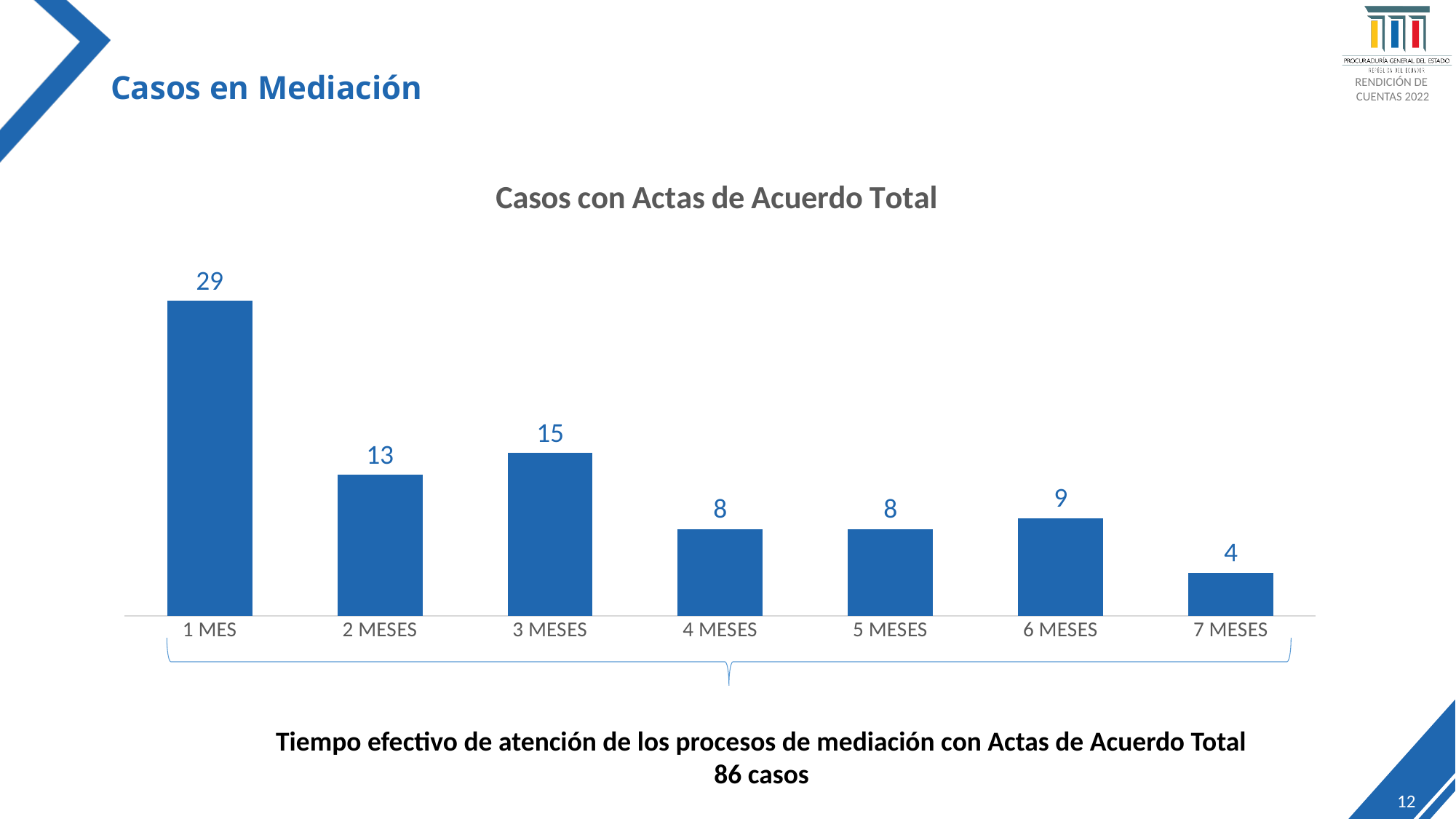
What is the title of the chart? Casos con Actas de Acuerdo Total Which category has the lowest value? 7 MESES What is the value for 1 MES? 29 What kind of chart is shown on the slide? Bar chart Which category has the highest value? 1 MES Which is larger, the value for 2 MESES or the value for 3 MESES? 3 MESES What is the value for 7 MESES? 4 What is the difference between the values for 1 MES and 2 MESES? 16 How many categories are shown on the x axis? 7 What is the value for 3 MESES? 15 What is the value for 6 MESES? 9 What is the total number of cases stated below the chart? 86 casos